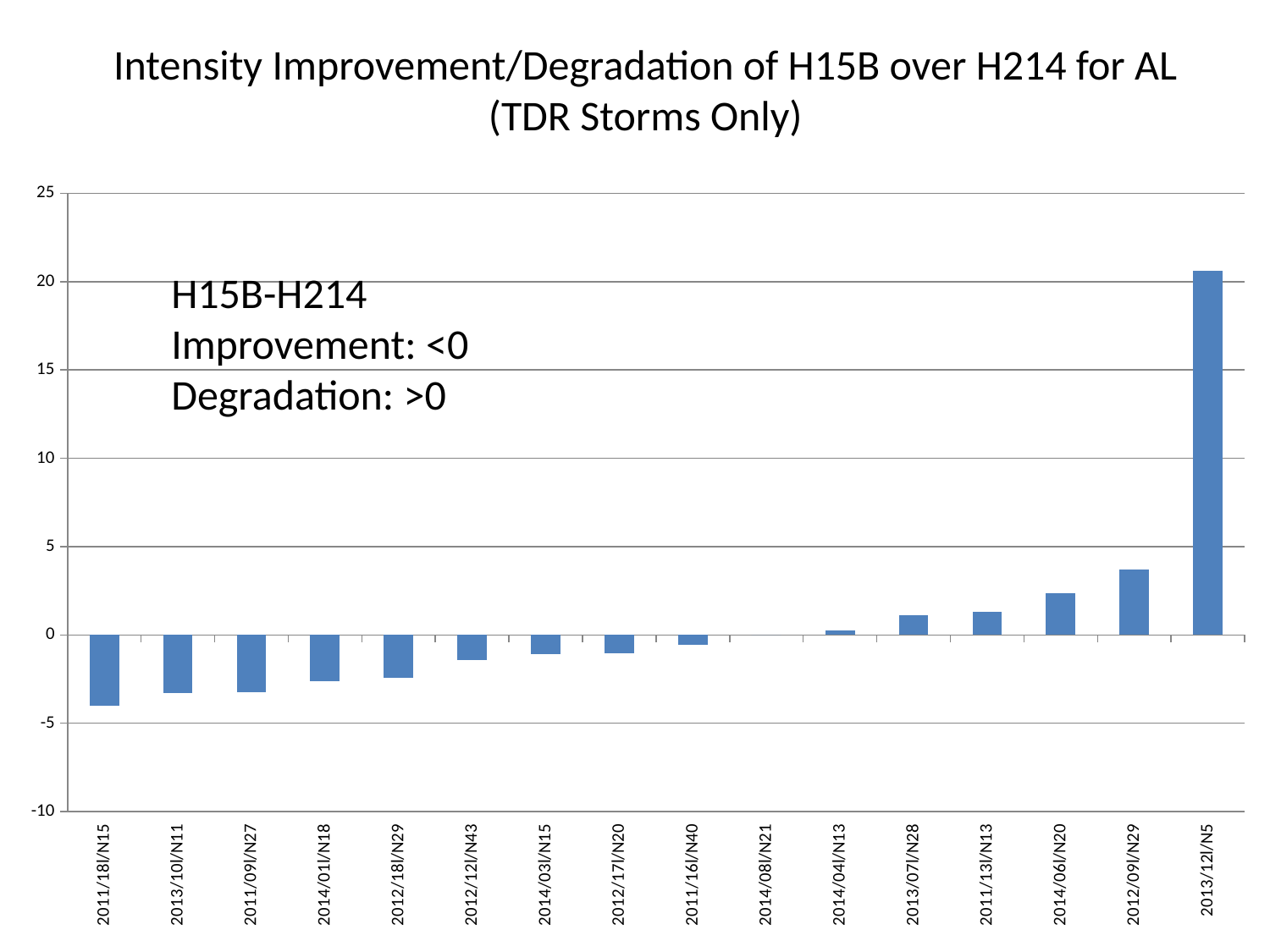
Which has the larger value, 2013/12l/N5 or 2012/09l/N29? 2013/12l/N5 Is the value for 2013/12l/N5 greater or less than 15? greater Which category has the lowest value? 2011/18l/N15 How many categories (storm cases) are plotted along the x axis? 16 According to the text on the chart, does a value below 0 indicate improvement or degradation? Improvement What kind of chart is shown on the slide? bar chart Do the values generally rise or fall moving from left to right along the x axis? rise Is the value for 2014/01l/N18 greater or less than 0? less Is the value for 2012/09l/N29 greater or less than 5? less Which category has the highest value? 2013/12l/N5 Which has the larger value, 2011/18l/N15 or 2014/06l/N20? 2014/06l/N20